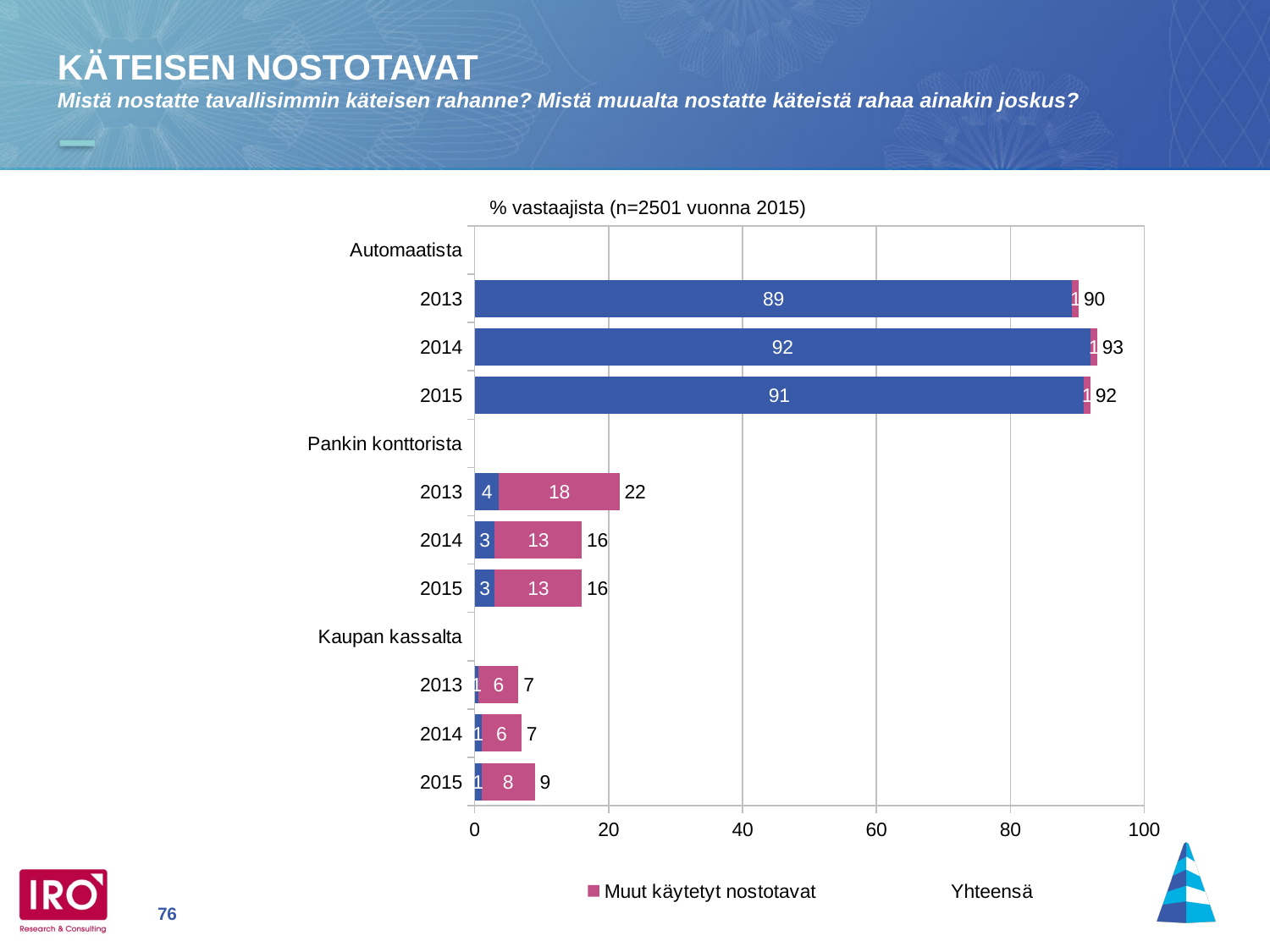
Is the Yhteensä value for Automaatista in 2013 greater or less than 80? greater What kind of chart is shown on the slide? bar chart What is the title shown above the chart? % vastaajista (n=2501 vuonna 2015) Which year has the larger Yhteensä value for Kaupan kassalta, 2014 or 2015? 2015 What is the total of the stacked bar for Pankin konttorista in 2014? 16 What is the Yhteensä (total) value for Automaatista in 2015? 92 Which year has the highest Yhteensä value for Automaatista? 2014 Which year has the highest Yhteensä value for Pankin konttorista? 2013 What is the Muut käytetyt nostotavat value for Kaupan kassalta in 2015? 8 How many stacked bars are plotted in the chart? 9 What is the Muut käytetyt nostotavat value for Pankin konttorista in 2013? 18 What is the difference between the Yhteensä values for Pankin konttorista in 2013 and 2015? 6